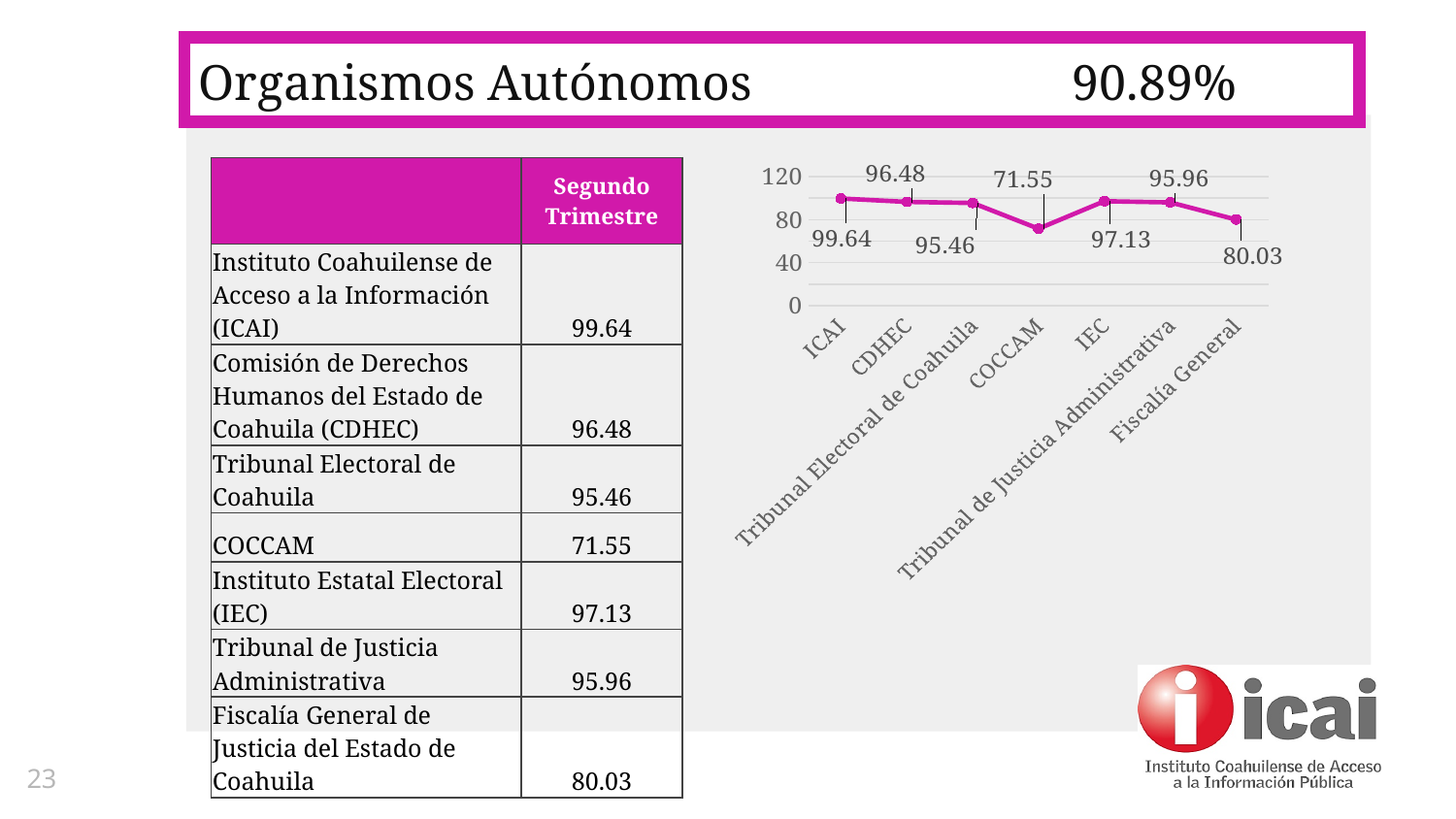
Which has a larger value in the line chart, CDHEC or Tribunal Electoral de Coahuila? CDHEC What is the value plotted for ICAI in the line chart? 99.64 What is the value plotted for Fiscalía General in the line chart? 80.03 What is the value plotted for COCCAM in the line chart? 71.55 What is the difference between the values for IEC and Fiscalía General in the line chart? 17.10 What kind of chart is shown on the slide? line chart What is the difference between the values for ICAI and COCCAM in the line chart? 28.09 Is the value for COCCAM in the line chart greater or less than 80? less What is the value plotted for IEC in the line chart? 97.13 Which category has the lowest value in the line chart? COCCAM How many categories are plotted along the x axis of the line chart? 7 Which category has the highest value in the line chart? ICAI